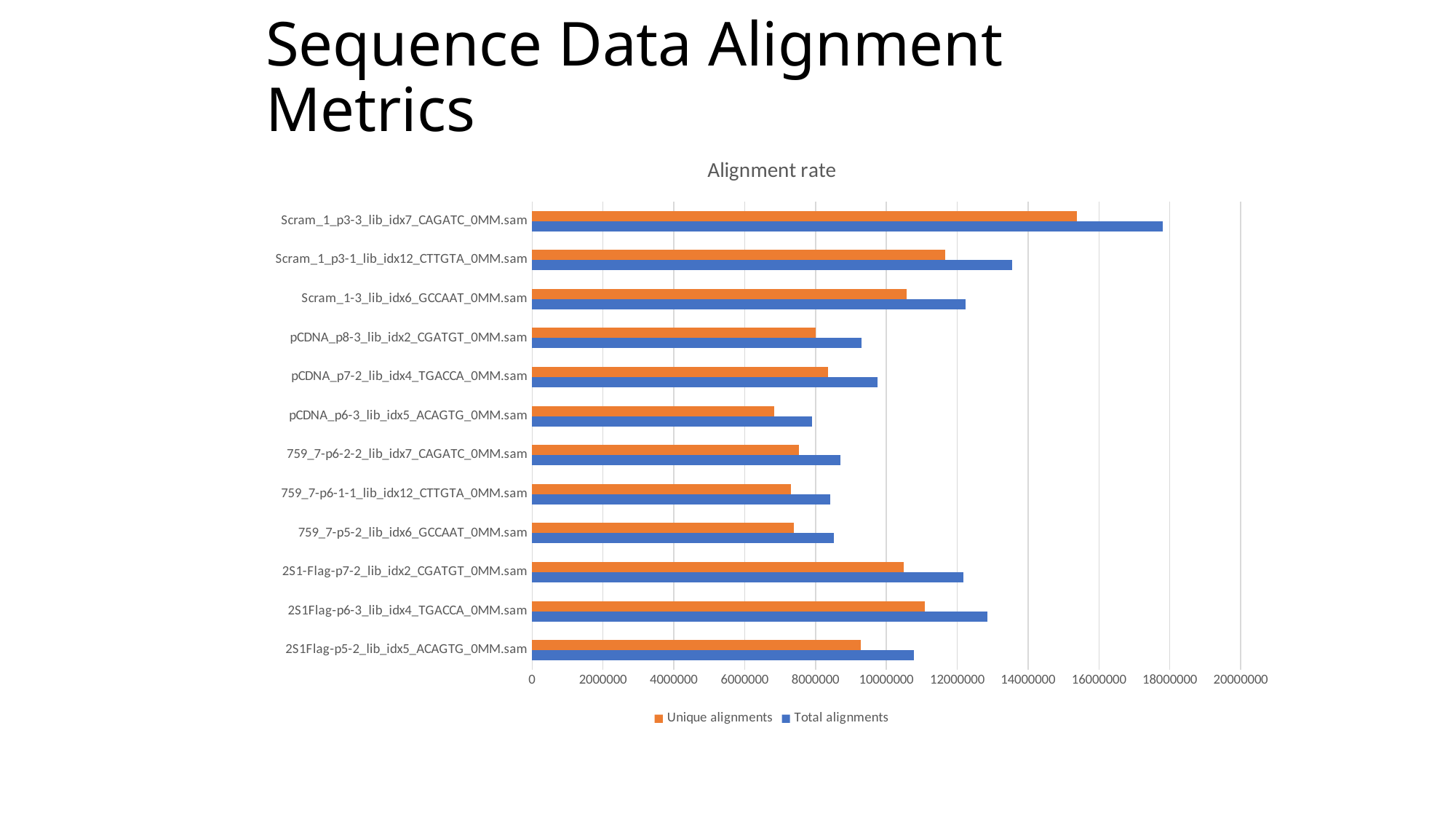
What kind of chart is shown on the slide? Bar chart Which is larger: the Unique alignments value for 2S1Flag-p6-3_lib_idx4_TGACCA_0MM.sam or for 2S1Flag-p5-2_lib_idx5_ACAGTG_0MM.sam? 2S1Flag-p6-3_lib_idx4_TGACCA_0MM.sam How many series does the legend list? 2 How many categories (sample files) are plotted on the chart? 12 Which sample has the lowest value for Unique alignments? pCDNA_p6-3_lib_idx5_ACAGTG_0MM.sam Is the Total alignments value for Scram_1_p3-3_lib_idx7_CAGATC_0MM.sam greater or less than 16000000? greater Which sample has the highest value for Unique alignments? Scram_1_p3-3_lib_idx7_CAGATC_0MM.sam Which is larger: the Total alignments value for Scram_1_p3-1_lib_idx12_CTTGTA_0MM.sam or for 2S1Flag-p6-3_lib_idx4_TGACCA_0MM.sam? Scram_1_p3-1_lib_idx12_CTTGTA_0MM.sam Is the Unique alignments value for pCDNA_p6-3_lib_idx5_ACAGTG_0MM.sam greater or less than 8000000? less What is the title of the chart? Alignment rate Which sample has the highest value for Total alignments? Scram_1_p3-3_lib_idx7_CAGATC_0MM.sam Is the Total alignments value for 2S1Flag-p5-2_lib_idx5_ACAGTG_0MM.sam greater or less than 10000000? greater